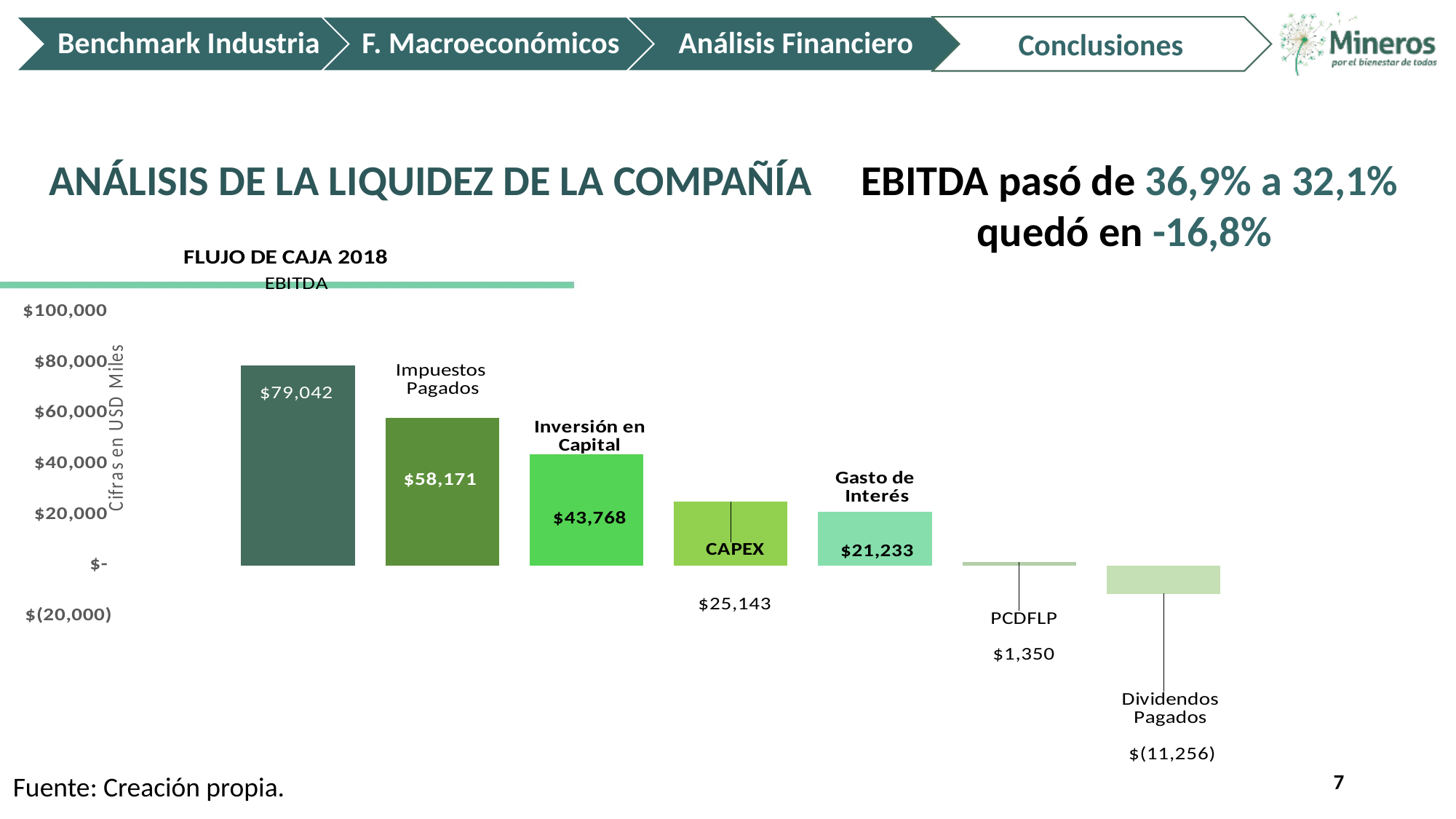
What value is shown for Inversión en Capital? $43,768 What kind of chart is the FLUJO DE CAJA 2018 chart? Bar chart What value is shown for Impuestos Pagados? $58,171 Which category has the lowest value in the FLUJO DE CAJA 2018 chart? Dividendos Pagados What value is shown for CAPEX? $25,143 Which is larger, the value for CAPEX or the value for Gasto de Interés? CAPEX What is the value of the EBITDA bar in the FLUJO DE CAJA 2018 chart? $79,042 What value is shown for Dividendos Pagados? $(11,256) How many categories are plotted in the FLUJO DE CAJA 2018 chart? 7 What is the difference between the EBITDA value and the Impuestos Pagados value? $20,871 Which category has the highest value in the FLUJO DE CAJA 2018 chart? EBITDA What is the label of the vertical axis in the FLUJO DE CAJA 2018 chart? Cifras en USD Miles